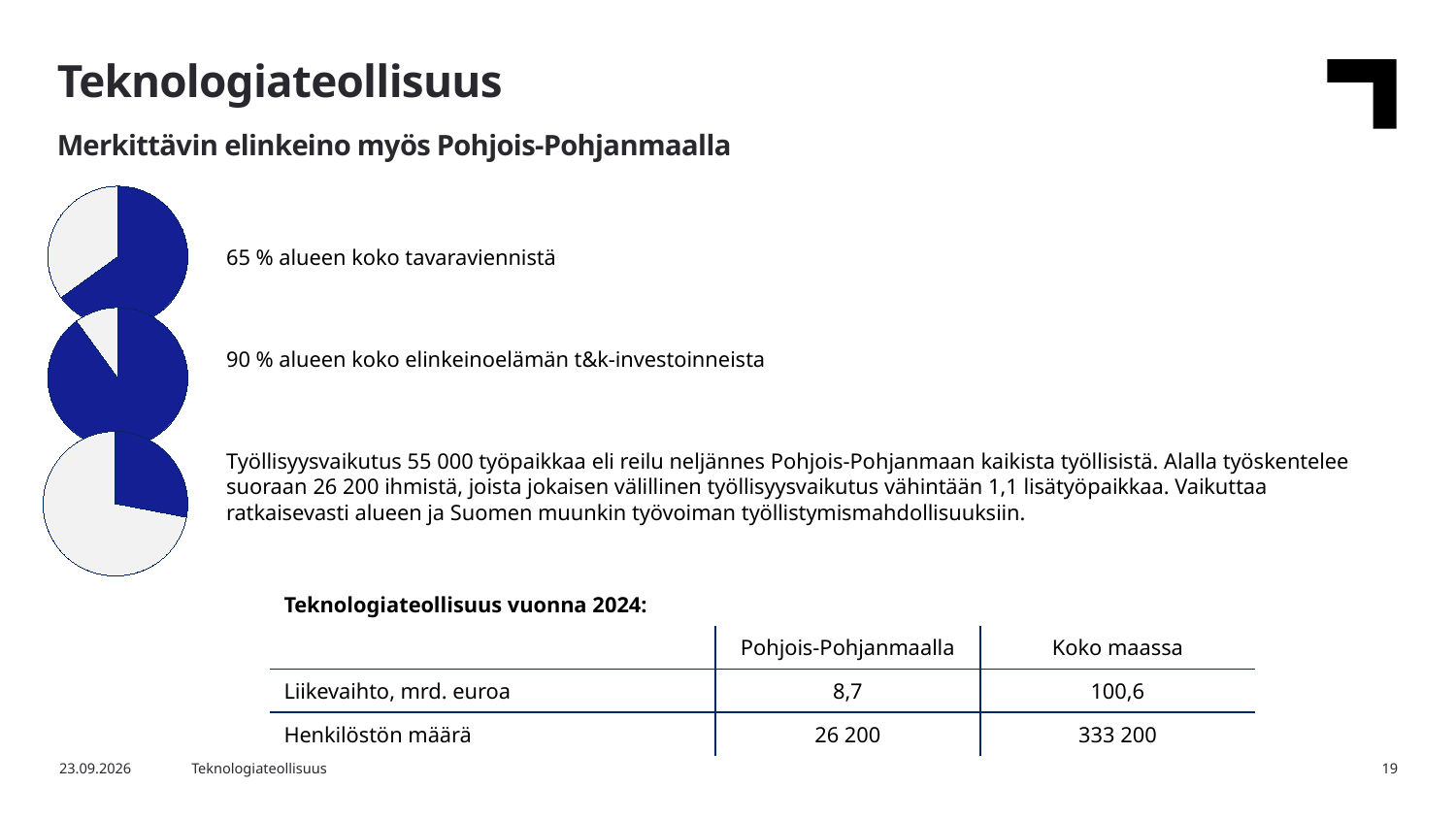
Which of the three pie charts has the largest blue slice? The middle one (t&k-investoinnit, 90 %) What share of the middle pie chart is shaded blue? 90 % By how many percentage points does the blue share in the middle pie chart (90 %) exceed the blue share in the top pie chart (65 %)? 25 percentage points In the top pie chart, what share of the region's total goods exports (tavaravienti) does the blue slice represent? 65 % In the middle pie chart, what share of the region's business R&D investments (t&k-investoinnit) does the blue slice represent? 90 % What colour is used for the highlighted slice in each pie chart? Blue Which is larger: the blue share in the top pie chart (tavaravienti) or in the middle pie chart (t&k-investoinnit)? The middle pie chart (t&k-investoinnit) Which of the three pie charts has the smallest blue slice? The bottom one (työllisyysvaikutus) What kind of charts are shown on the left side of the slide? Pie charts Is the blue slice in the bottom pie chart greater or less than 50 %? less How many pie charts are on the slide? 3 What does the top pie chart represent, according to the text next to it? 65 % alueen koko tavaraviennistä